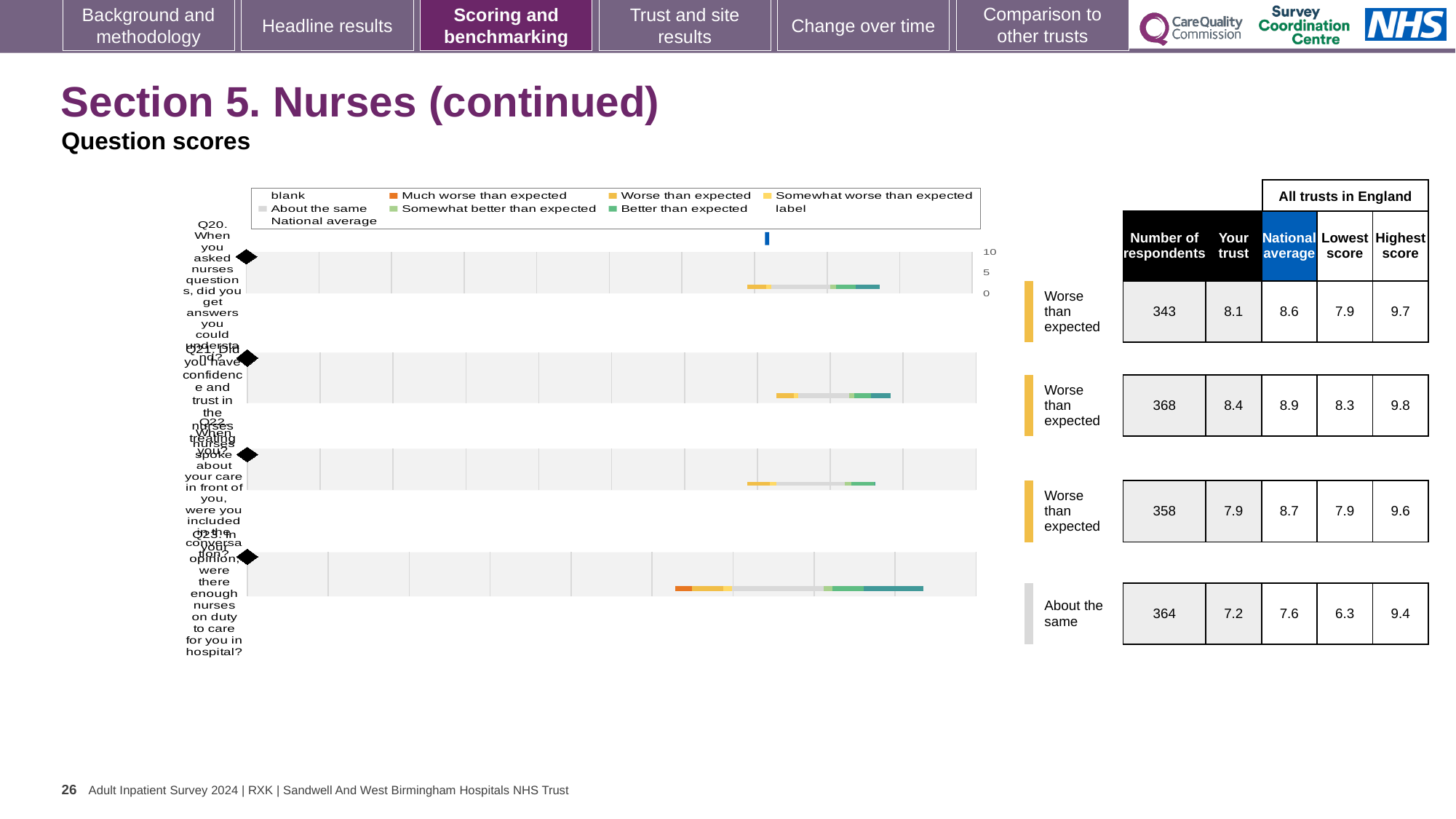
Which question has the highest 'Your trust' score? Q21 How many entries does the chart legend list? 9 What benchmark category is shown for Q23? About the same How many respondents answered Q20? 343 What is the 'Your trust' score for Q23 (were there enough nurses on duty to care for you in hospital)? 7.2 How many questions (categories) are plotted in the chart? 4 What kind of chart is shown on the slide? bar chart What is the highest score across all trusts in England for Q21? 9.8 What is the difference between the national average and the 'Your trust' score for Q22? 0.8 What is the national average score for Q21 (did you have confidence and trust in the nurses treating you)? 8.9 Is the 'Your trust' score for Q20 larger or smaller than the national average for Q20? smaller Which question has the lowest 'Your trust' score? Q23